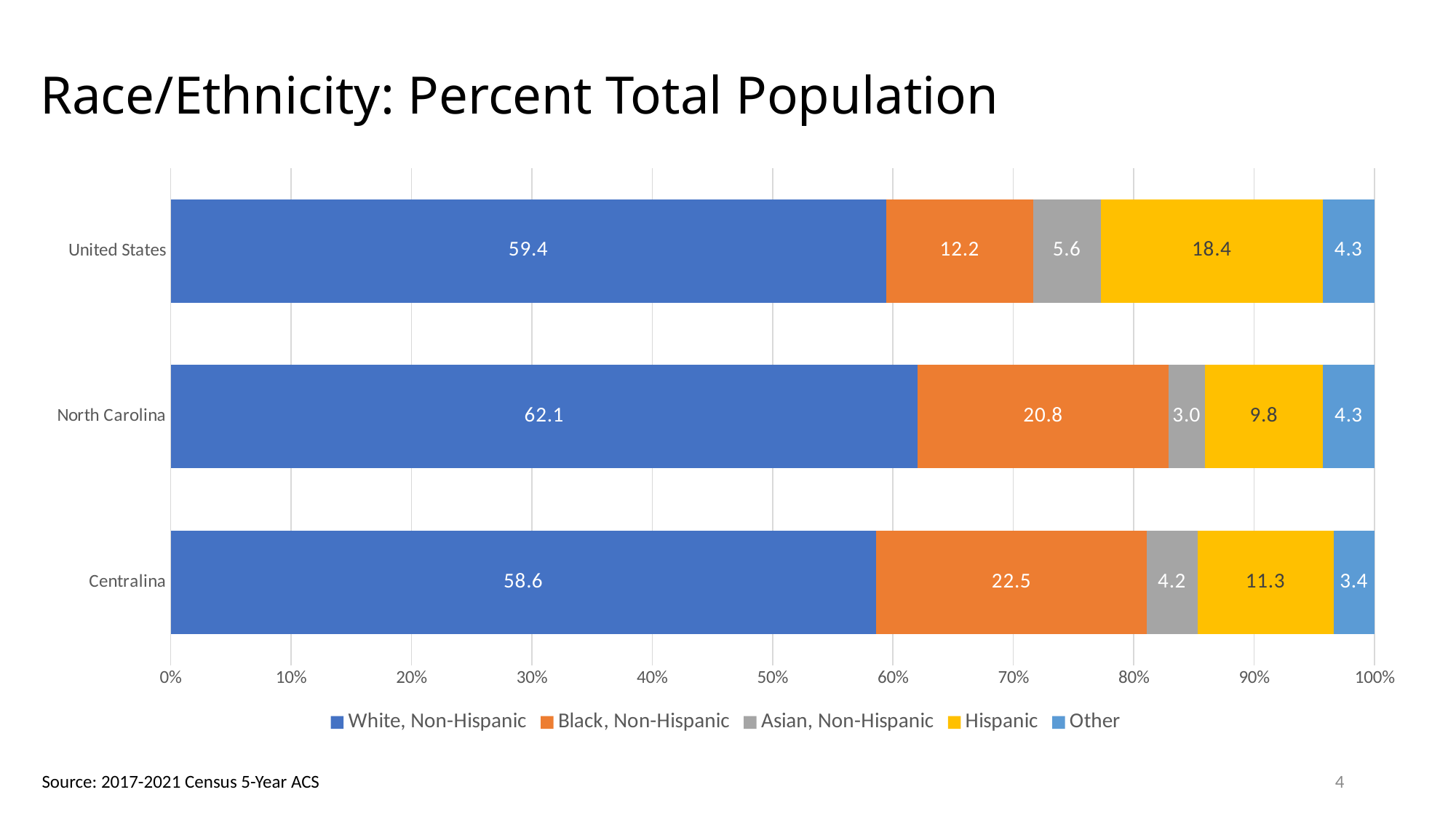
What is the difference between the Hispanic values for the United States and North Carolina? 8.6 What is the White, Non-Hispanic value for North Carolina? 62.1 What is the Hispanic value for the United States? 18.4 What is the title of the chart? Race/Ethnicity: Percent Total Population Which is larger, the Asian, Non-Hispanic value for the United States or for Centralina? United States Which region has the lowest Other value? Centralina Is the White, Non-Hispanic value for Centralina greater or less than 50%? greater How many series does the legend list? 5 What kind of chart is shown on the slide? Stacked bar chart What is the Black, Non-Hispanic value for Centralina? 22.5 Which region has the highest Black, Non-Hispanic value? Centralina How many regions are shown on the chart? 3